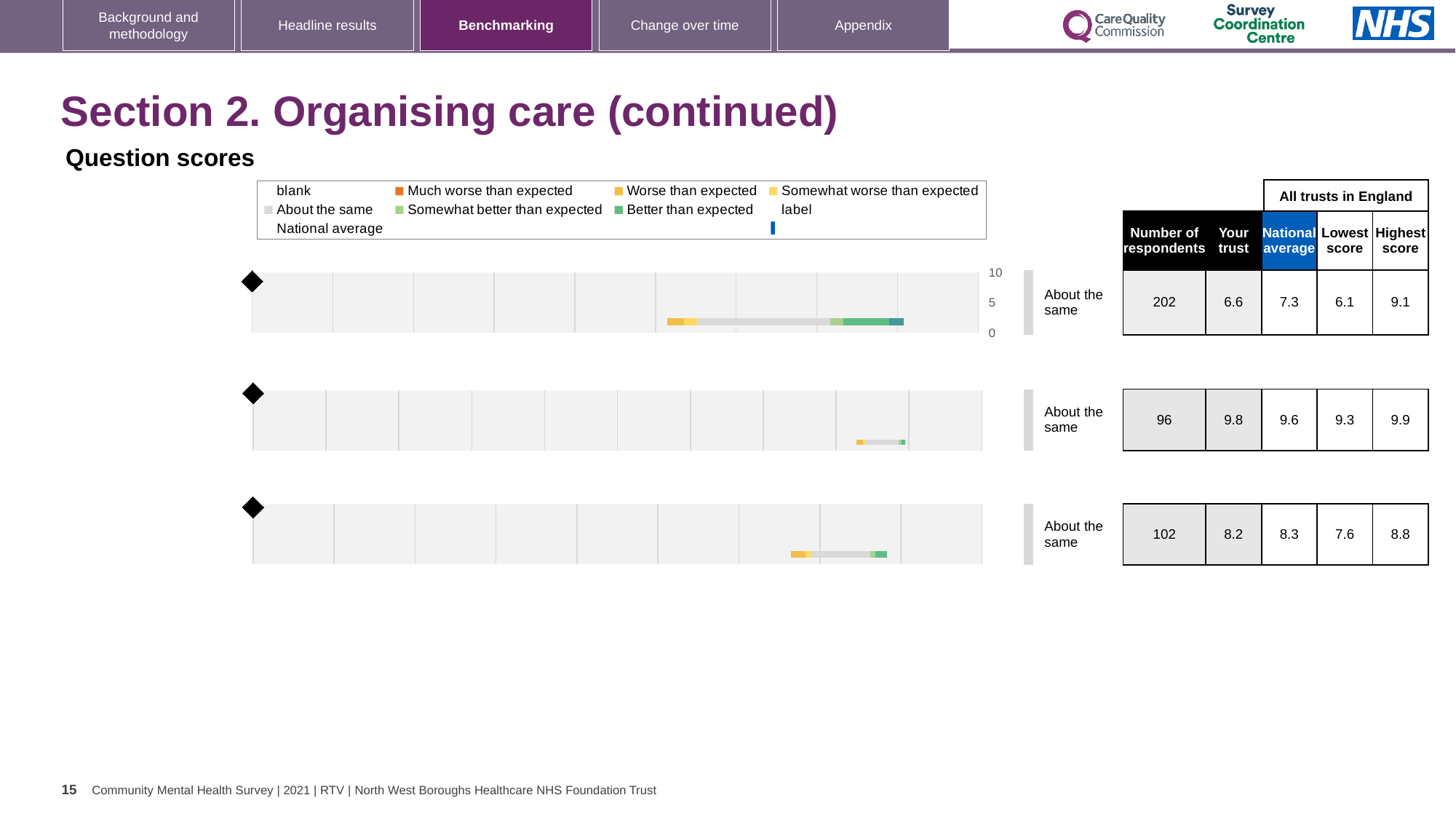
In the top chart, what is the national average score? 7.3 In the middle chart, which is larger: the 'Your trust' score or the national average? Your trust In the top chart, what is the 'Your trust' score? 6.6 In the top chart, what is the difference between the highest score and the lowest score? 3.0 How many benchmarking charts are shown on the slide? 3 In the middle chart, what is the lowest score among all trusts in England? 9.3 In the middle chart, how many respondents are there? 96 What benchmark category is shown next to each of the three charts? About the same In the bottom chart, what is the highest score among all trusts in England? 8.8 In the bottom chart, which is larger: the 'Your trust' score or the national average? National average In the top chart, is the 'Your trust' score greater or less than 5? greater Which chart has the largest number of respondents? The top chart (202)